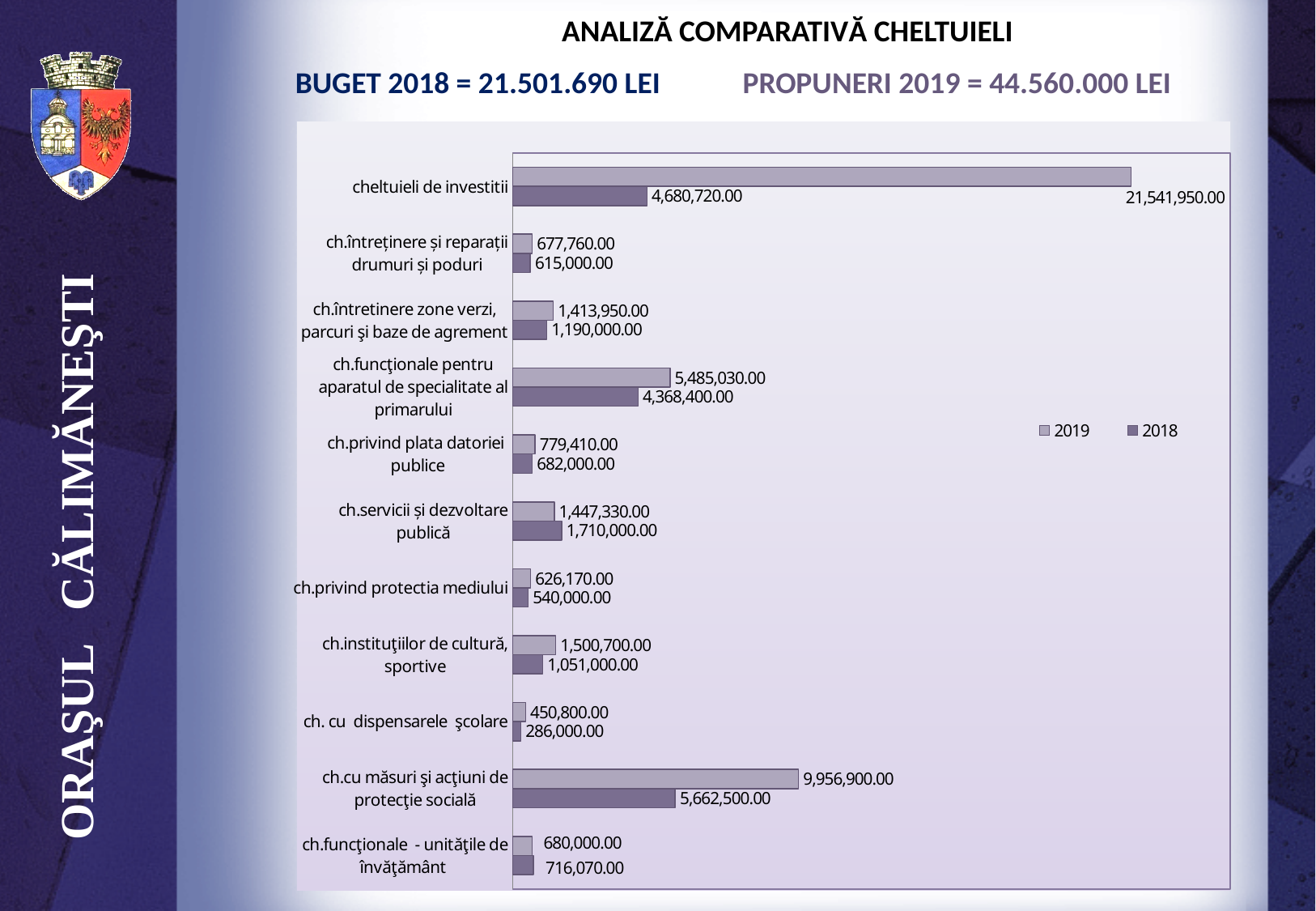
How many expenditure categories are plotted in the chart? 11 What is the 2018 value for 'ch.cu măsuri şi acţiuni de protecţie socială'? 5,662,500.00 What are the two series names shown in the legend? 2019 and 2018 How many series does the legend list? 2 What is the difference between the 2019 and 2018 values for 'cheltuieli de investitii'? 16,861,230.00 For 'ch.servicii și dezvoltare publică', which year has the larger value, 2018 or 2019? 2018 What is the 2019 value for 'cheltuieli de investitii'? 21,541,950.00 What is the 2019 value for 'ch. cu dispensarele şcolare'? 450,800.00 Which category has the lowest 2018 value? ch. cu dispensarele şcolare Which category has the highest 2019 value? cheltuieli de investitii What is the difference between the 2019 and 2018 values for 'ch.cu măsuri şi acţiuni de protecţie socială'? 4,294,400.00 What type of chart is shown on the slide? bar chart